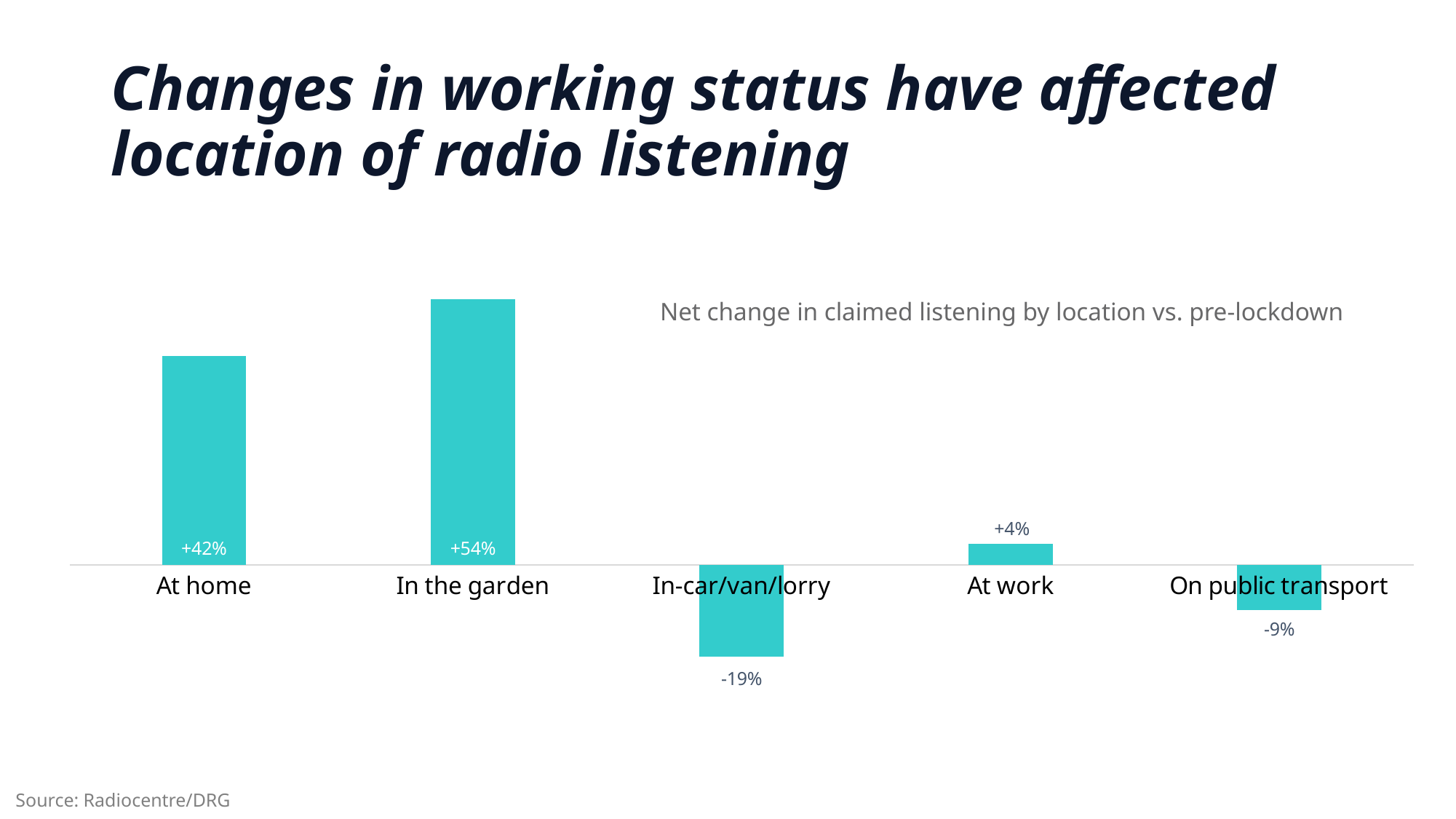
What is the net change in claimed listening for At work? +4% What is the net change in claimed listening for In-car/van/lorry? -19% Which location has the highest net change in claimed listening? In the garden Which location has the lowest net change in claimed listening? In-car/van/lorry What is the net change in claimed listening for In the garden? +54% What is the net change in claimed listening for At home? +42% What is the difference between the net change for In the garden and At home? 12 percentage points What is the subtitle of the chart? Net change in claimed listening by location vs. pre-lockdown What is the net change in claimed listening for On public transport? -9% Which has a larger net change in claimed listening, At work or On public transport? At work What kind of chart is shown on the slide? Bar chart How many locations are shown in the chart? 5